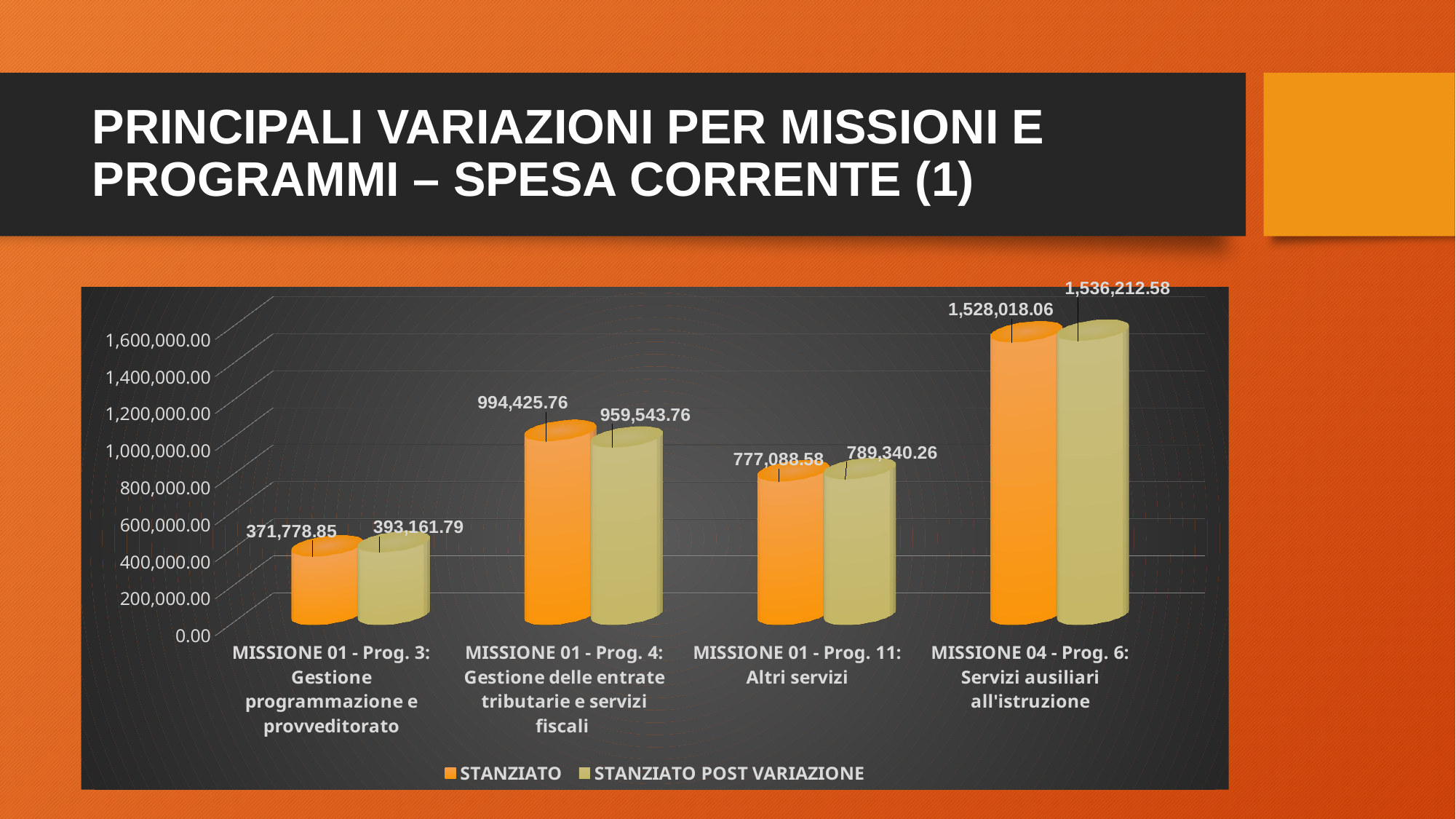
What type of chart is shown on the slide? Bar chart Which category has the lowest STANZIATO POST VARIAZIONE value? MISSIONE 01 - Prog. 3: Gestione programmazione e provveditorato What is the STANZIATO POST VARIAZIONE value for MISSIONE 04 - Prog. 6: Servizi ausiliari all'istruzione? 1,536,212.58 What is the STANZIATO value for MISSIONE 01 - Prog. 3: Gestione programmazione e provveditorato? 371,778.85 How many categories are shown on the x axis? 4 For MISSIONE 01 - Prog. 4, which is larger: STANZIATO or STANZIATO POST VARIAZIONE? STANZIATO Which category has the highest STANZIATO value? MISSIONE 04 - Prog. 6: Servizi ausiliari all'istruzione What is the difference between STANZIATO POST VARIAZIONE and STANZIATO for MISSIONE 01 - Prog. 3? 21,382.94 What is the difference between STANZIATO and STANZIATO POST VARIAZIONE for MISSIONE 01 - Prog. 4? 34,882.00 How many series does the legend list? 2 What is the STANZIATO value for MISSIONE 01 - Prog. 11: Altri servizi? 777,088.58 What is the STANZIATO POST VARIAZIONE value for MISSIONE 01 - Prog. 4: Gestione delle entrate tributarie e servizi fiscali? 959,543.76